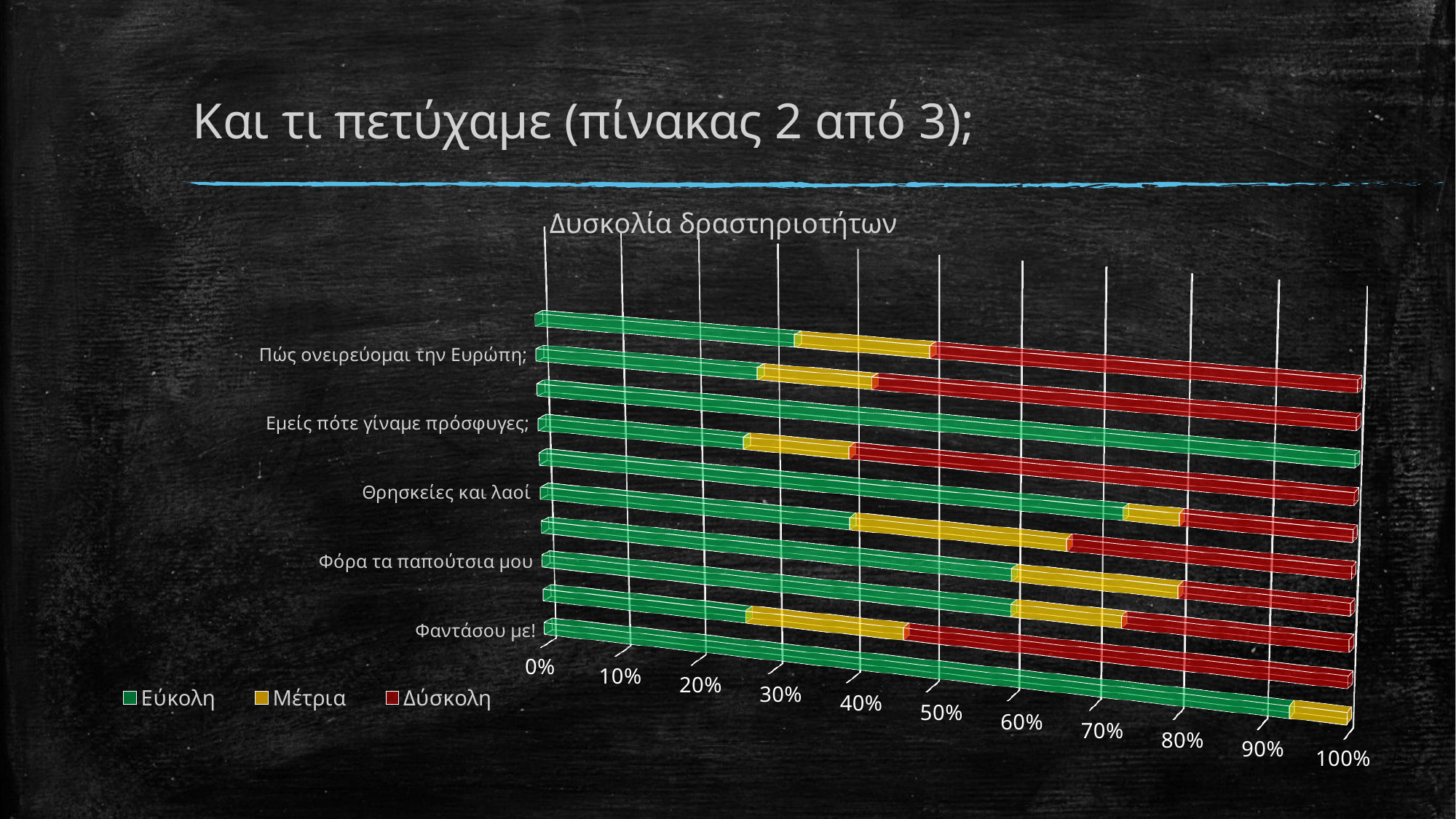
In the bottom bar (Φαντάσου με!), which series takes up the largest share? Εύκολη In the bottom bar (Φαντάσου με!), which is larger: the Εύκολη share or the Μέτρια share? Εύκολη What kind of chart is shown on the slide? Stacked bar chart What is the title of the chart? Δυσκολία δραστηριοτήτων In the bottom bar (Φαντάσου με!), is the Εύκολη share greater or less than 80%? greater Which colour represents the series Δύσκολη in the chart? Red In the top bar of the chart, is the Εύκολη share greater or less than 50%? less In the top bar of the chart, which series takes up the largest share? Δύσκολη How many series does the legend list? 3 In the top bar of the chart, which is larger: the Δύσκολη share or the Μέτρια share? Δύσκολη